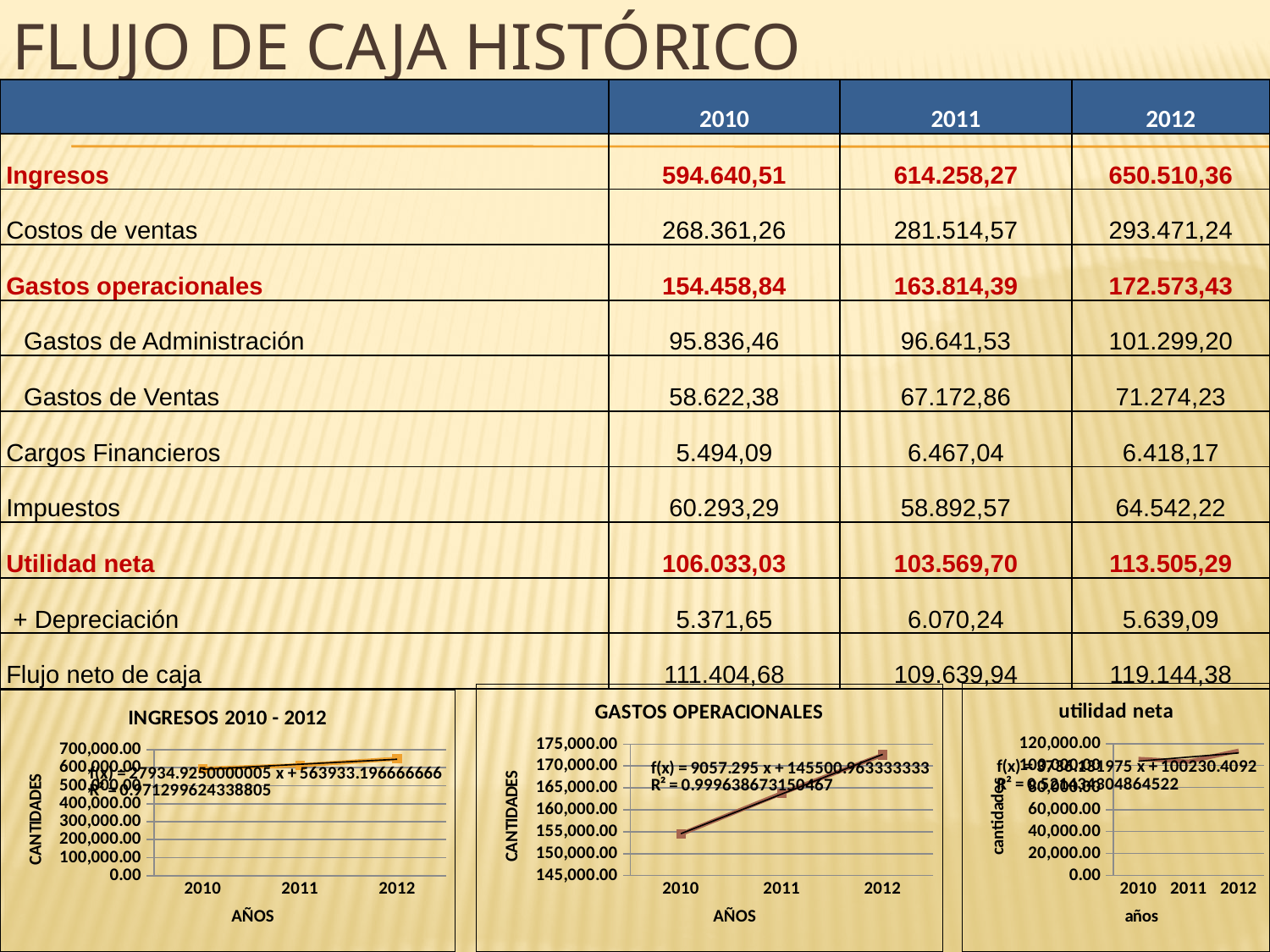
In the "INGRESOS 2010 - 2012" chart, which year has the lowest value? 2010 In the "GASTOS OPERACIONALES" chart, is the value for 2012 greater or less than 170,000.00? greater What is the x-axis title of the "GASTOS OPERACIONALES" chart? AÑOS What R² value is shown on the "GASTOS OPERACIONALES" chart? 0.999638673150467 In the "INGRESOS 2010 - 2012" chart, do the values rise or fall from 2010 to 2012? rise In the "GASTOS OPERACIONALES" chart, is the value for 2010 greater or less than 160,000.00? less In the "utilidad neta" chart, is the value for 2012 greater or less than 100,000.00? greater What kind of chart is the "INGRESOS 2010 - 2012" chart? line chart In the "GASTOS OPERACIONALES" chart, do the values rise or fall from 2010 to 2012? rise In the "GASTOS OPERACIONALES" chart, which year has the highest value? 2012 How many years are plotted on the x axis of the "GASTOS OPERACIONALES" chart? 3